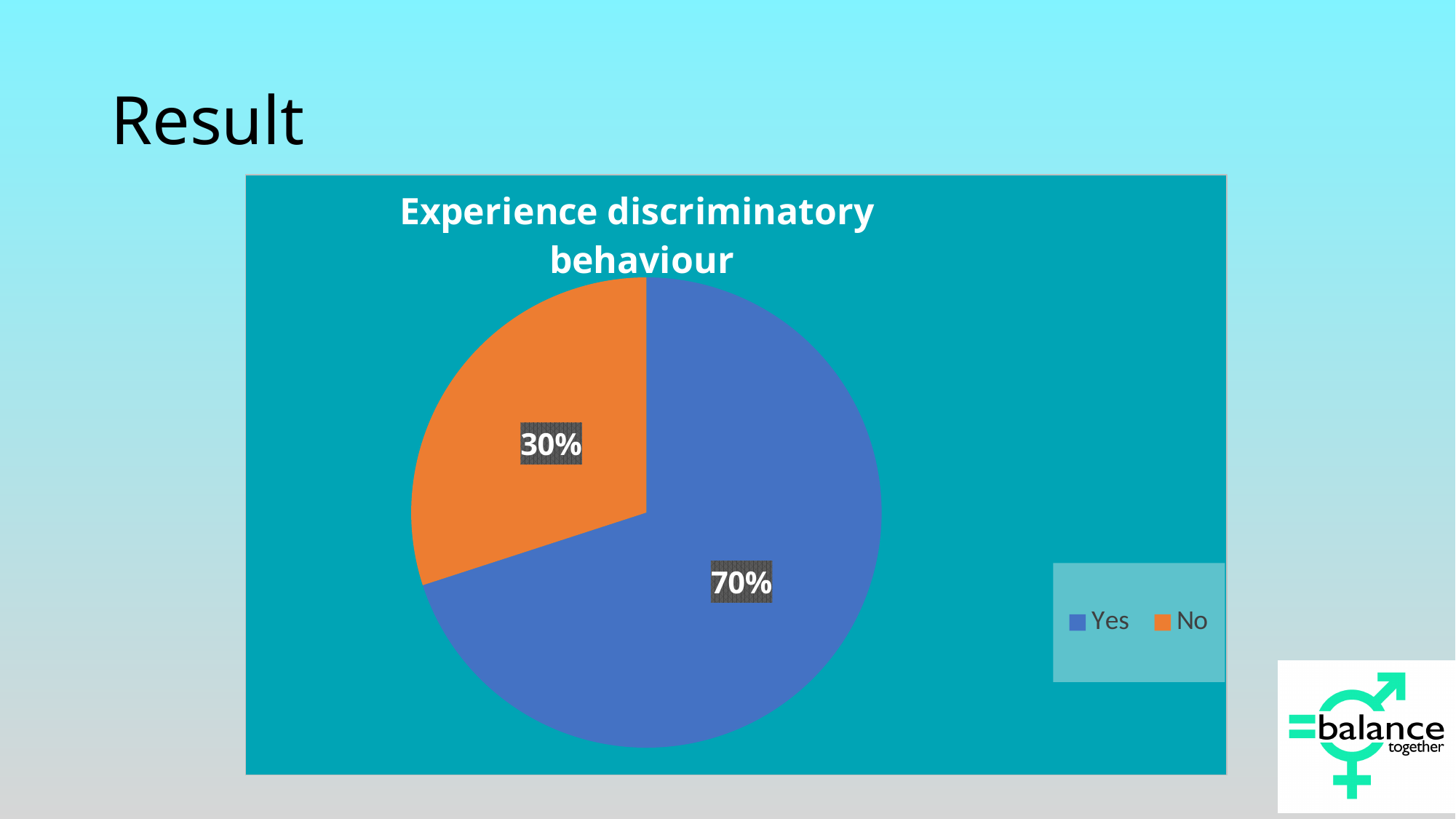
What kind of chart is shown on the slide? pie chart What colour is the "Yes" slice? blue How many entries does the legend list? 2 Which slice is larger, "Yes" or "No"? Yes What share of the pie does the "No" slice represent? 30% Which slice is the smallest? No What percentage of the pie is labelled "No"? 30% What is the title of the chart? Experience discriminatory behaviour How many slices does the pie chart have? 2 What percentage of the pie is labelled "Yes"? 70% Which slice is the largest? Yes What is the difference in percentage points between the "Yes" and "No" slices? 40